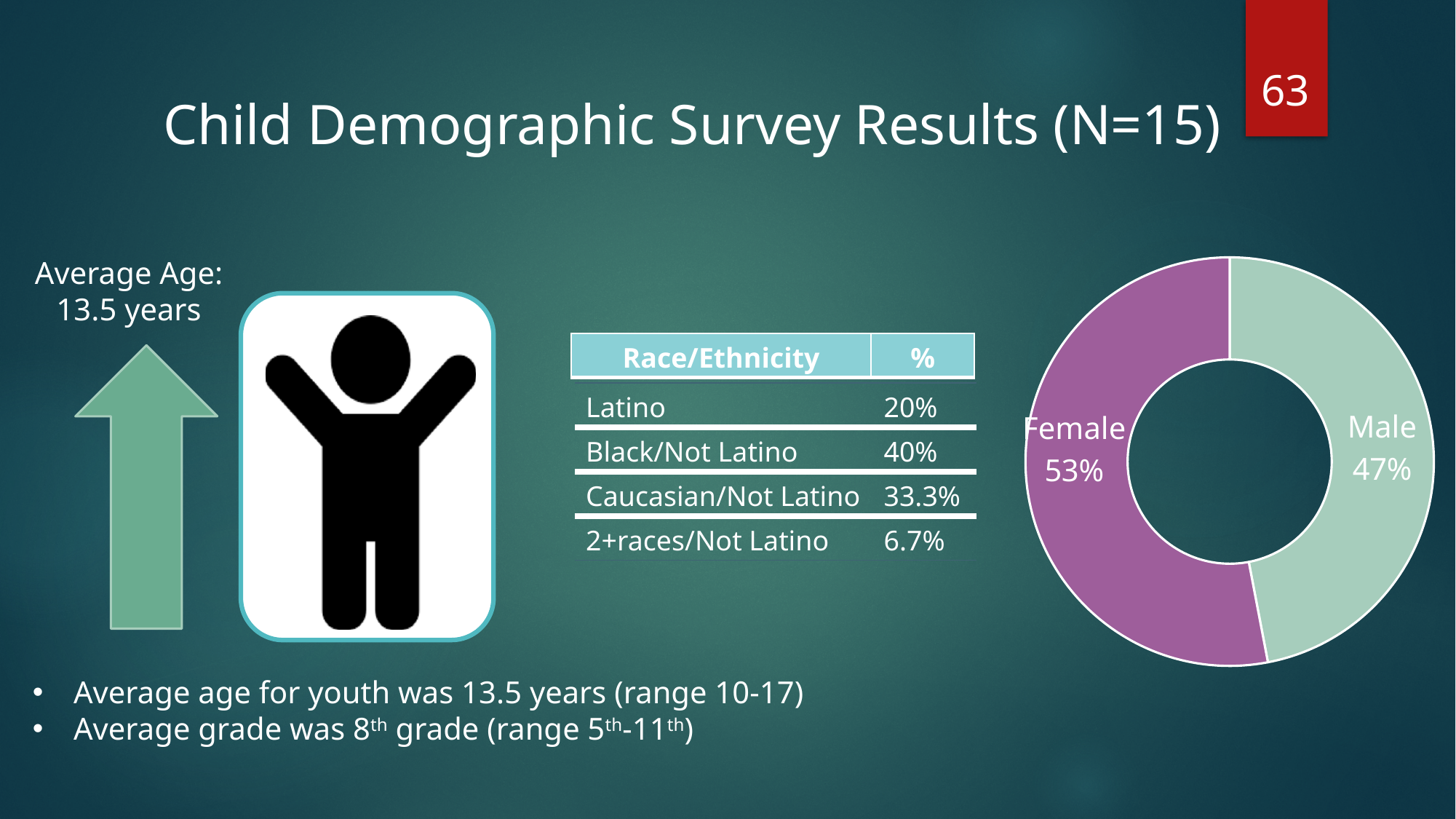
Is the female share or the male share larger in the doughnut chart? Female How many slices does the doughnut chart have? 2 What colour is the Male slice in the doughnut chart? Light green What percentage of the children surveyed are female, according to the doughnut chart? 53% What kind of chart is used to show the gender breakdown on the slide? Doughnut chart Which gender has the larger share in the doughnut chart? Female What is the total of the two slices in the doughnut chart? 100% Which gender has the smaller share in the doughnut chart? Male By how many percentage points does the female share exceed the male share in the doughnut chart? 6 percentage points What percentage of the children surveyed are male, according to the doughnut chart? 47% What share of the doughnut chart does the Male slice represent? 47% What colour is the Female slice in the doughnut chart? Purple